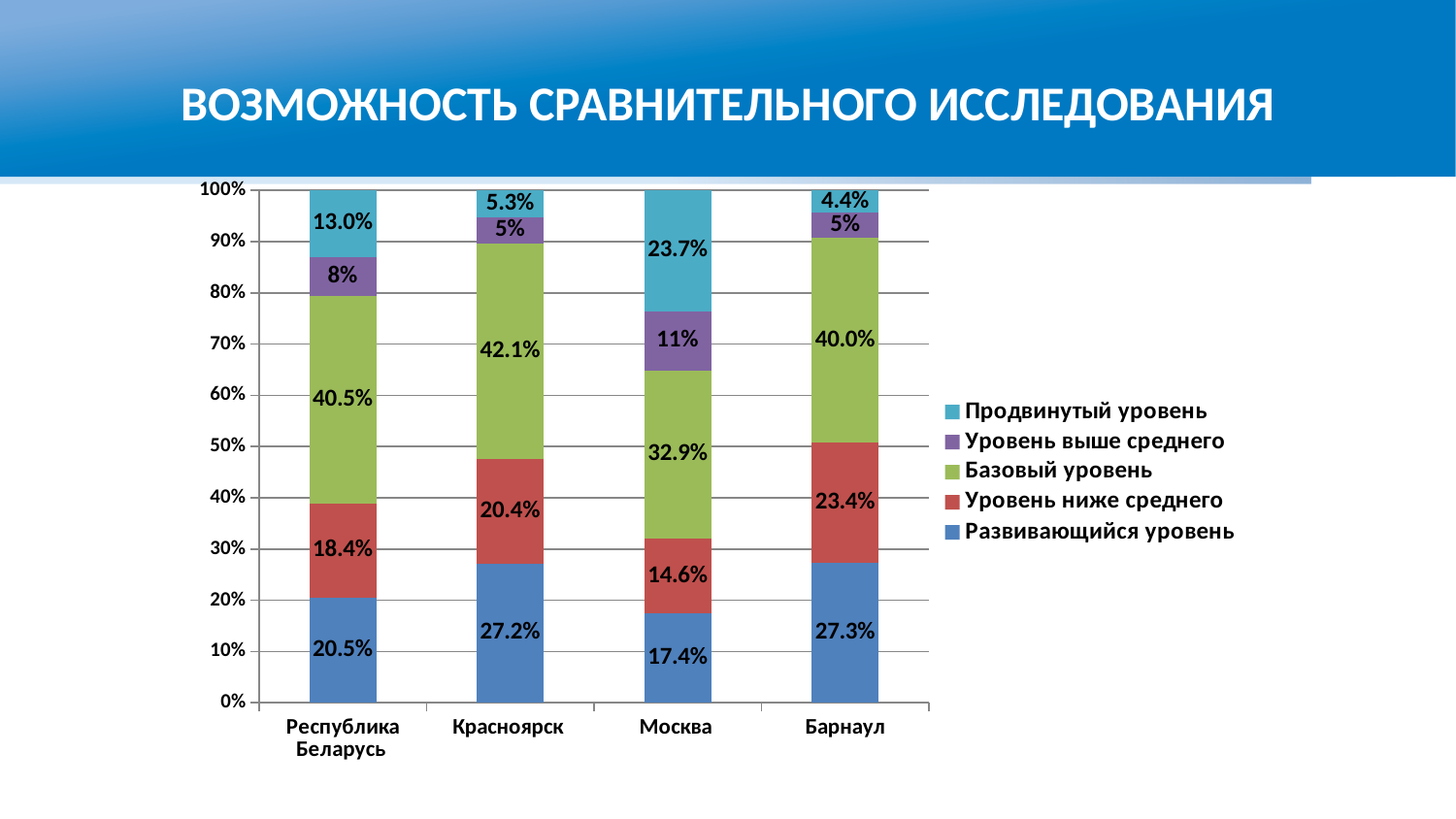
What is the value for Базовый уровень in Москва? 32.9% How many series does the legend list? 5 Which is larger: the Уровень ниже среднего value for Барнаул or for Республика Беларусь? Барнаул What is the value for Развивающийся уровень in Республика Беларусь? 20.5% How many categories are shown on the x axis? 4 What is the value for Уровень ниже среднего in Красноярск? 20.4% Which category has the lowest value for Развивающийся уровень? Москва What kind of chart is shown on the slide? Stacked bar chart Which category has the highest value for Продвинутый уровень? Москва What is the title of the slide? ВОЗМОЖНОСТЬ СРАВНИТЕЛЬНОГО ИССЛЕДОВАНИЯ What is the value for Продвинутый уровень in Барнаул? 4.4% What is the difference between the Базовый уровень values for Красноярск and Барнаул? 2.1 percentage points